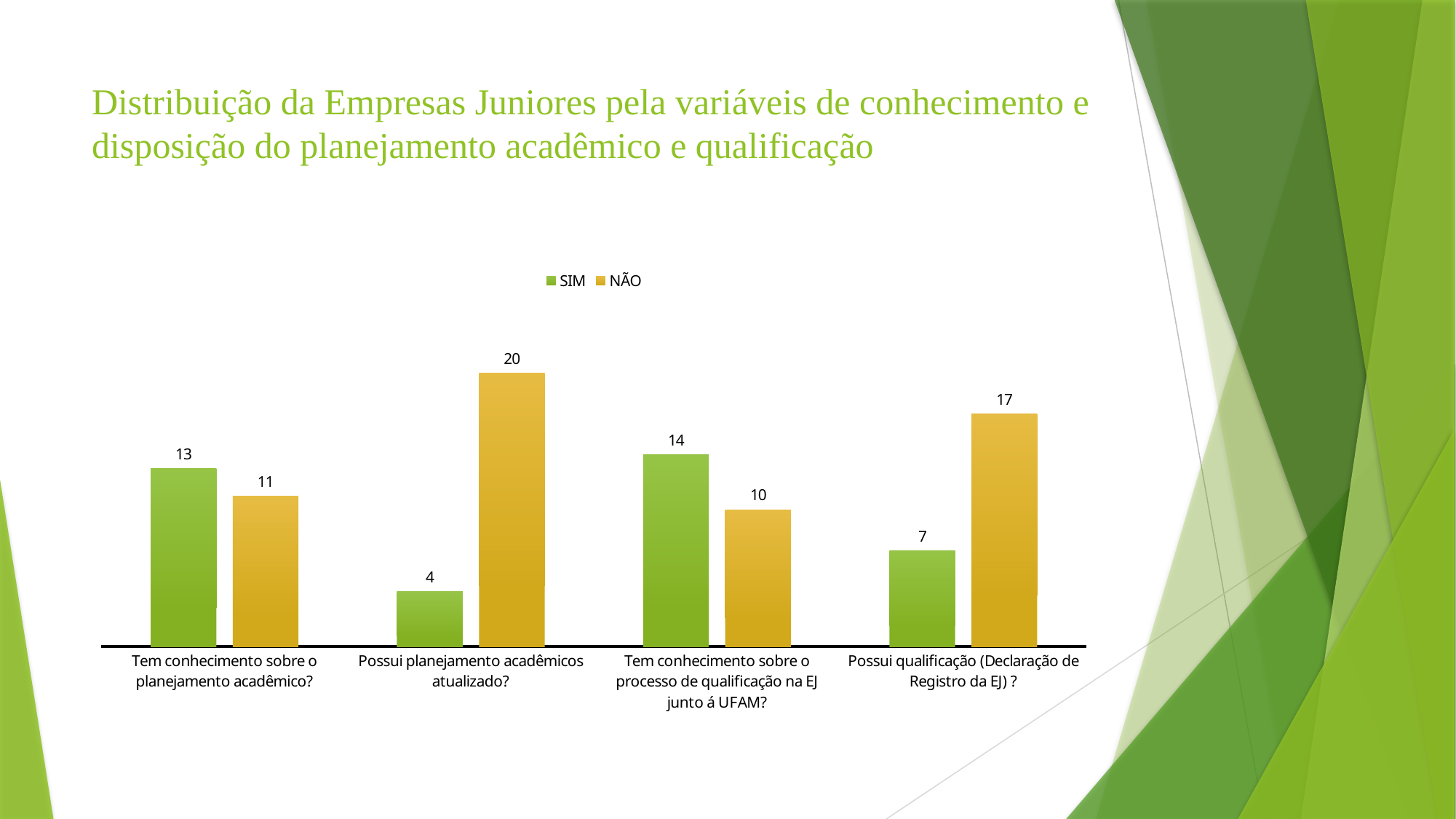
What is the NÃO value for "Tem conhecimento sobre o processo de qualificação na EJ junto á UFAM?"? 10 What kind of chart is shown on the slide? Bar chart For "Possui qualificação (Declaração de Registro da EJ) ?", which is larger, SIM or NÃO? NÃO Which category has the highest SIM value? Tem conhecimento sobre o processo de qualificação na EJ junto á UFAM? How many categories are shown on the x axis? 4 Which category has the lowest SIM value? Possui planejamento acadêmicos atualizado? What is the SIM value for "Tem conhecimento sobre o planejamento acadêmico?"? 13 What is the NÃO value for "Possui planejamento acadêmicos atualizado?"? 20 What is the difference between the NÃO and SIM values for "Possui planejamento acadêmicos atualizado?"? 16 How many series does the legend list? 2 What colour are the NÃO bars? Orange/gold What is the SIM value for "Possui qualificação (Declaração de Registro da EJ) ?"? 7